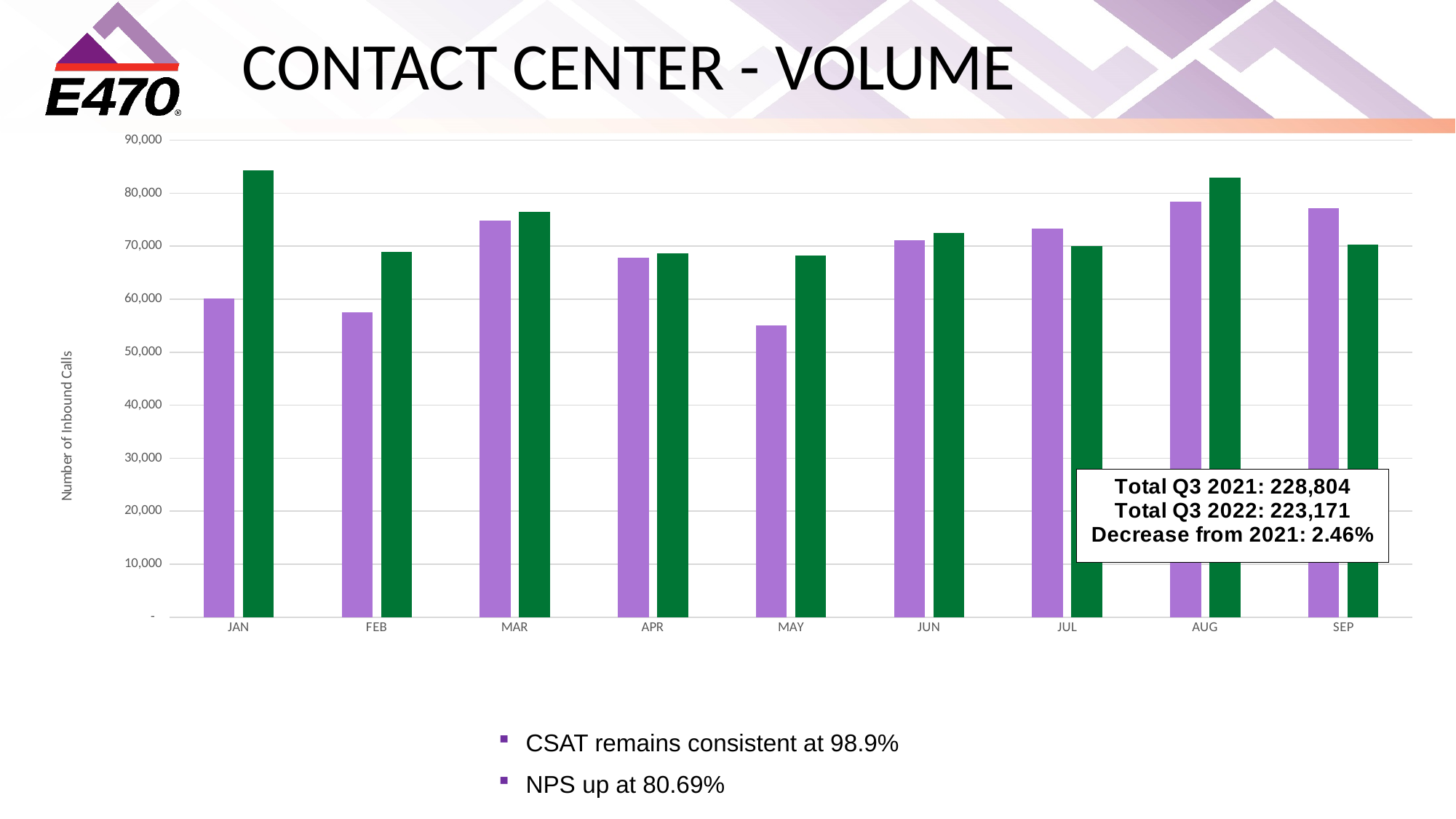
Is the value of the green bar for JAN greater or less than 80,000? greater How many months are shown on the x axis of the chart? 9 Is the value of the purple bar for MAY greater or less than 60,000? less In which month is the purple bar the lowest? MAY Is the value of the purple bar for MAR greater or less than 70,000? greater What is the title of the slide containing the chart? CONTACT CENTER - VOLUME Do the purple bars rise or fall from MAY to AUG? rise For SEP, which bar is larger, the purple bar or the green bar? purple What kind of chart is shown on the slide? bar chart For JAN, which bar is larger, the purple bar or the green bar? green What is the label on the vertical axis of the chart? Number of Inbound Calls